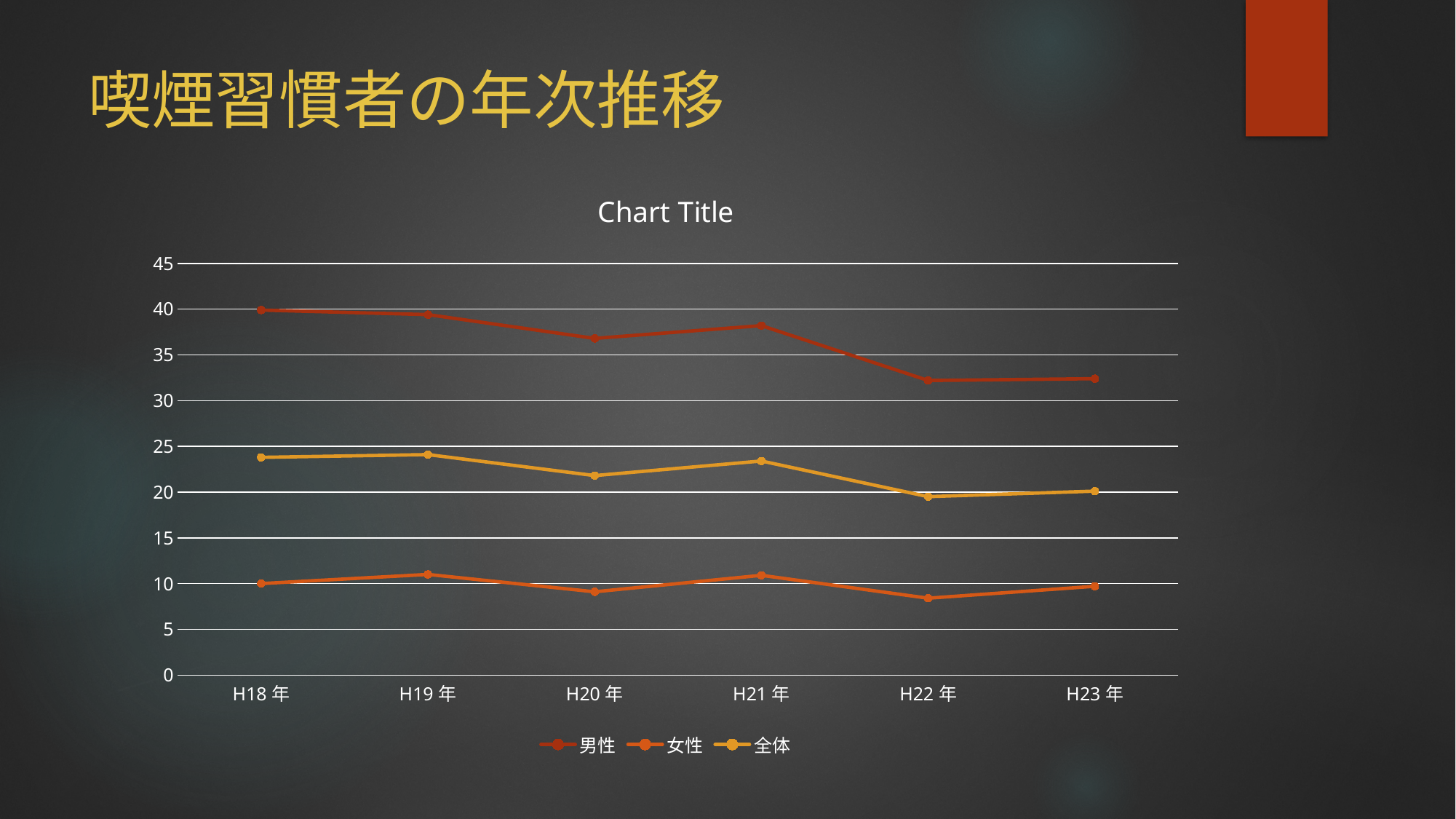
How many series does the legend list? 3 Is the value for 全体 in H21 年 greater or less than 20? greater Is the value for 全体 in H18 年 greater or less than 25? less How many years are shown on the x axis? 6 Is the value for 男性 in H20 年 greater or less than 35? greater Does the 男性 line generally rise or fall from H18 年 to H23 年? fall What is the title shown above the chart? Chart Title What kind of chart is shown on the slide? line chart In which year is the value for 女性 lowest? H22 年 Which series has the higher value in H21 年, 男性 or 全体? 男性